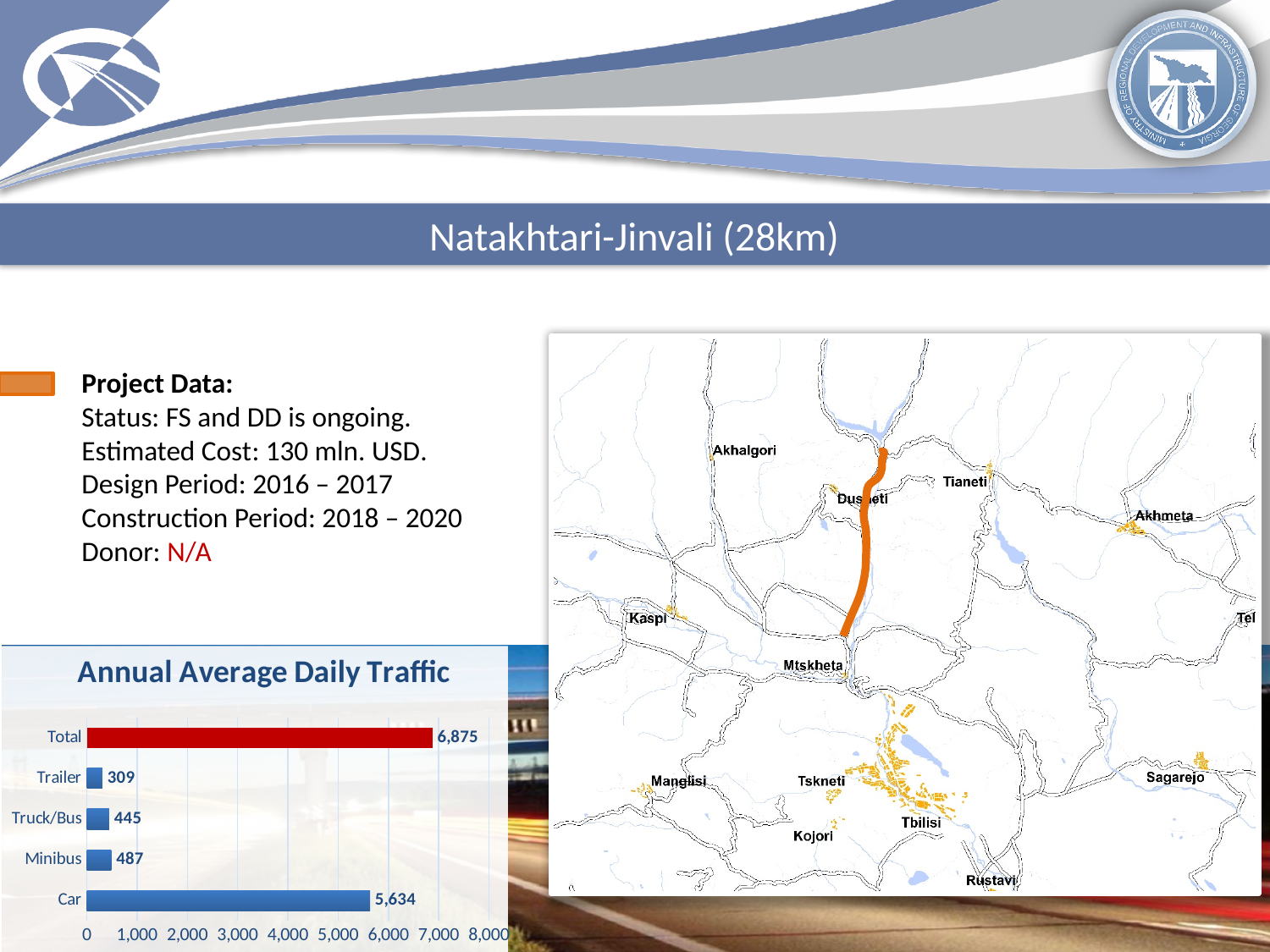
What is the value for Minibus in the Annual Average Daily Traffic chart? 487 Which category has the lowest value in the Annual Average Daily Traffic chart? Trailer What type of chart is the Annual Average Daily Traffic chart? Bar chart How many categories are shown in the Annual Average Daily Traffic chart? 5 Which is larger in the Annual Average Daily Traffic chart, Minibus or Trailer? Minibus Excluding Total, which vehicle category has the highest value in the Annual Average Daily Traffic chart? Car What is the difference between the Minibus and Truck/Bus values in the Annual Average Daily Traffic chart? 42 What is the Total value shown in the Annual Average Daily Traffic chart? 6,875 Is the value for Car in the Annual Average Daily Traffic chart greater or less than 5,000? greater What is the value for Truck/Bus in the Annual Average Daily Traffic chart? 445 What is the value for Car in the Annual Average Daily Traffic chart? 5,634 What is the value for Trailer in the Annual Average Daily Traffic chart? 309